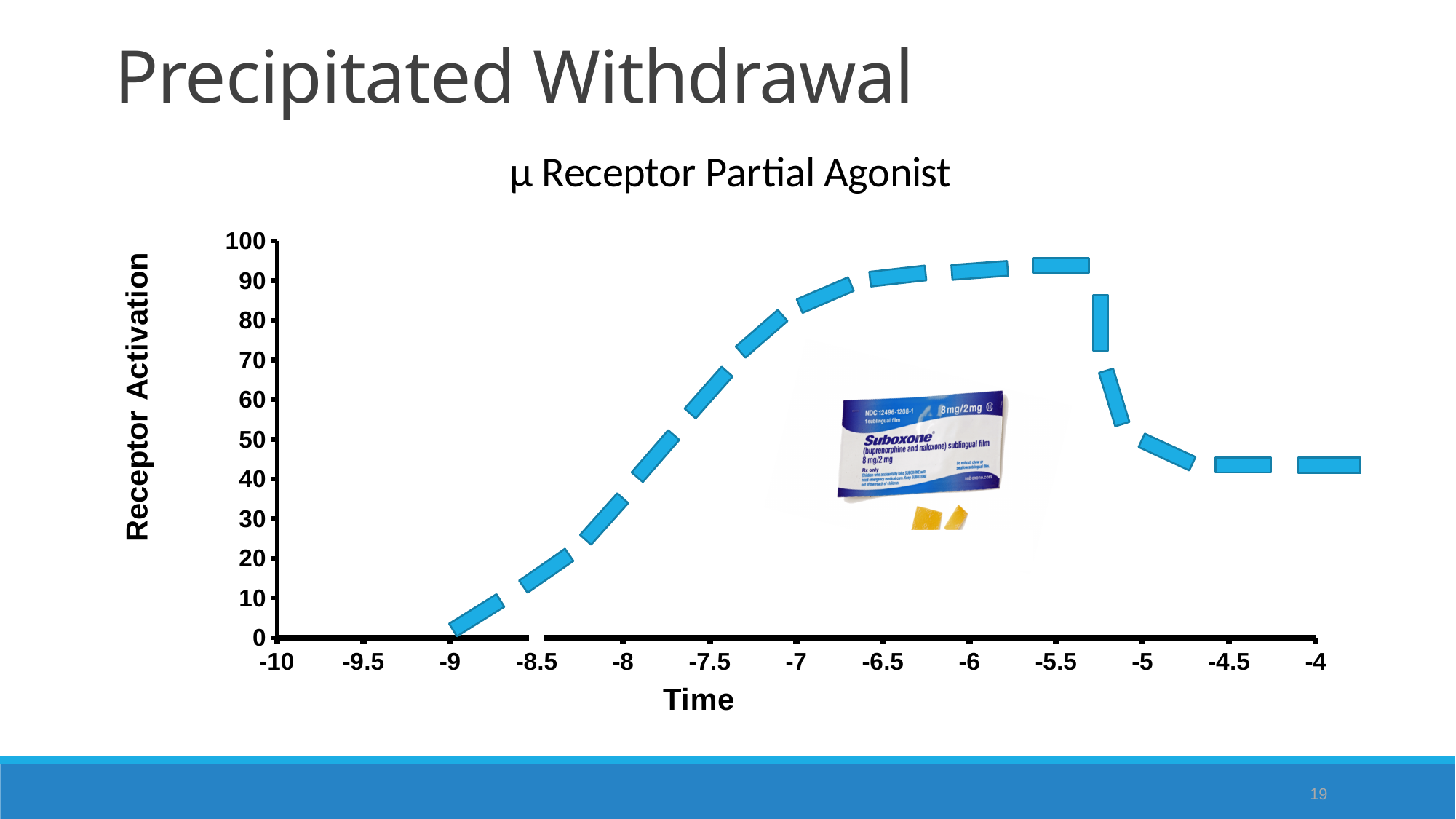
Does the line rise or fall between Time -9 and Time -6? rise Is the value for Time -5.5 greater or less than 80? greater Is the value for Time -4 greater or less than 50? less What kind of chart is shown on the slide? line chart What is the title of the chart? μ Receptor Partial Agonist How many tick labels are shown on the x axis? 13 What is the label of the y axis? Receptor Activation Is the value for Time -6 greater or less than 80? greater Does the line rise or fall between Time -5.5 and Time -5? fall Which is larger, the value at Time -6 or the value at Time -4? Time -6